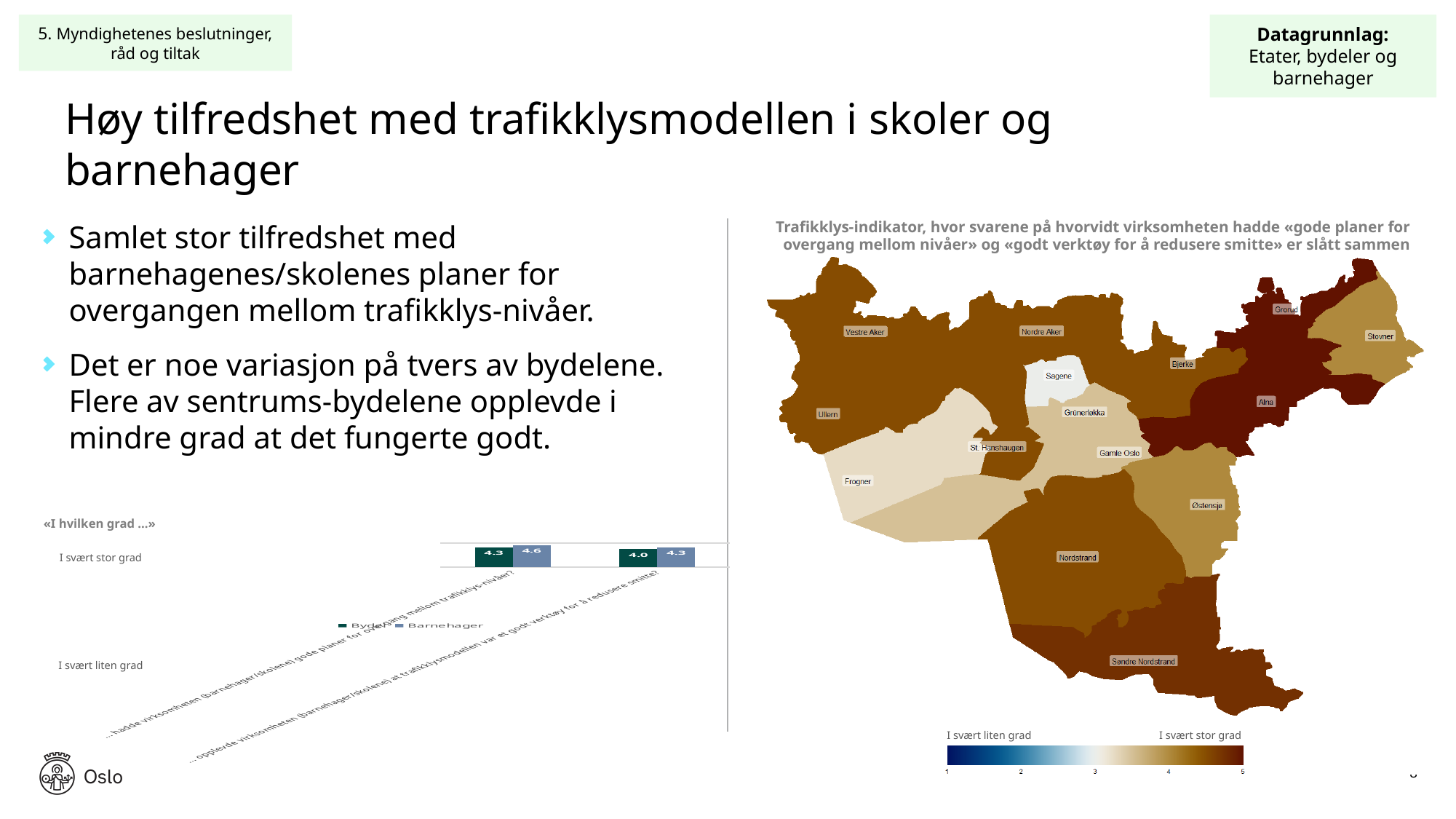
In the bar chart at the bottom left, what is the value for Bydel on the question about whether the traffic-light model was a good tool for reducing infection? 4.0 In the bar chart at the bottom left, how many series does the legend list? 2 In the bar chart at the bottom left, which of the four plotted values is the lowest? 4.0 In the bar chart at the bottom left, which of the four plotted values is the highest? 4.6 On the map on the right, what is the highest value shown on the colour scale? 5 In the bar chart at the bottom left, which series has the higher value on the question about the traffic-light model being a good tool for reducing infection, Bydel or Barnehager? Barnehager In the bar chart at the bottom left, what is the value for Barnehager on the question about having good plans for the transition between traffic-light levels? 4.6 In the bar chart at the bottom left, what is the value for Bydel on the question about having good plans for the transition between traffic-light levels? 4.3 In the bar chart at the bottom left, what is the value for Barnehager on the question about whether the traffic-light model was a good tool for reducing infection? 4.3 What kind of chart is shown at the bottom left of the slide? Bar chart In the bar chart at the bottom left, which series does the legend list first? Bydel In the bar chart at the bottom left, what is the difference between the Barnehager and Bydel values on the question about good plans for the transition between traffic-light levels? 0.3